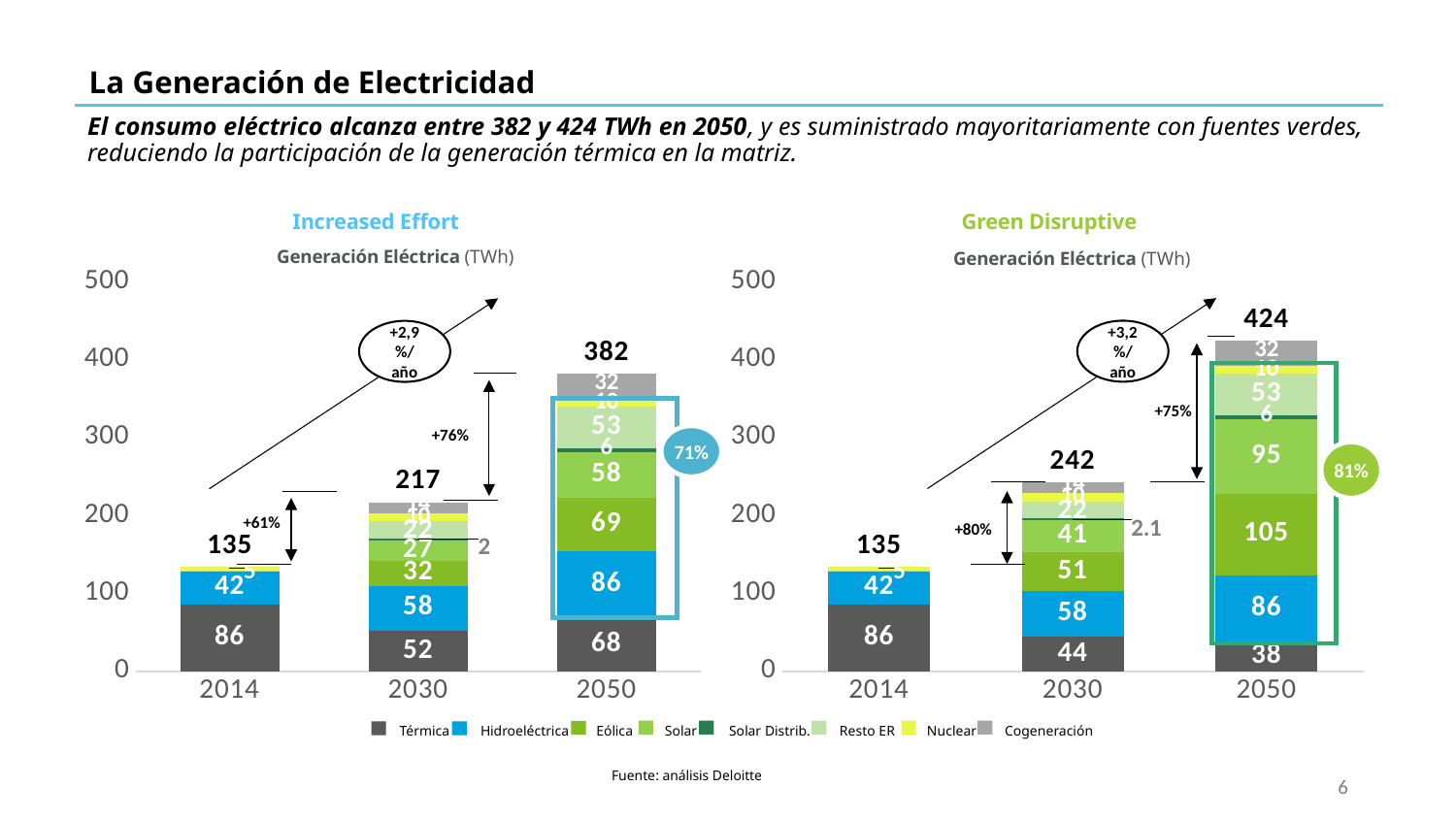
In the Green Disruptive chart, do the total generation values rise or fall from 2014 to 2050? Rise In the Green Disruptive chart, is the Eólica value for 2050 larger than the Solar value for 2050? Yes In the Green Disruptive chart, which year has the highest total generation? 2050 In the Increased Effort chart, what is the difference between the Térmica values for 2014 and 2050? 18 In the Green Disruptive chart, what is the Térmica value for 2050? 38 How many series does the legend list? 8 In the Increased Effort chart, what is the total generation shown for 2050? 382 In the Increased Effort chart, what is the Térmica value for 2014? 86 In the Green Disruptive chart, what is the total generation shown for 2050? 424 In the Green Disruptive chart, what is the Eólica value for 2050? 105 In the Increased Effort chart, what is the Hidroeléctrica value for 2050? 86 What kind of chart is used in the Increased Effort panel? Stacked bar chart